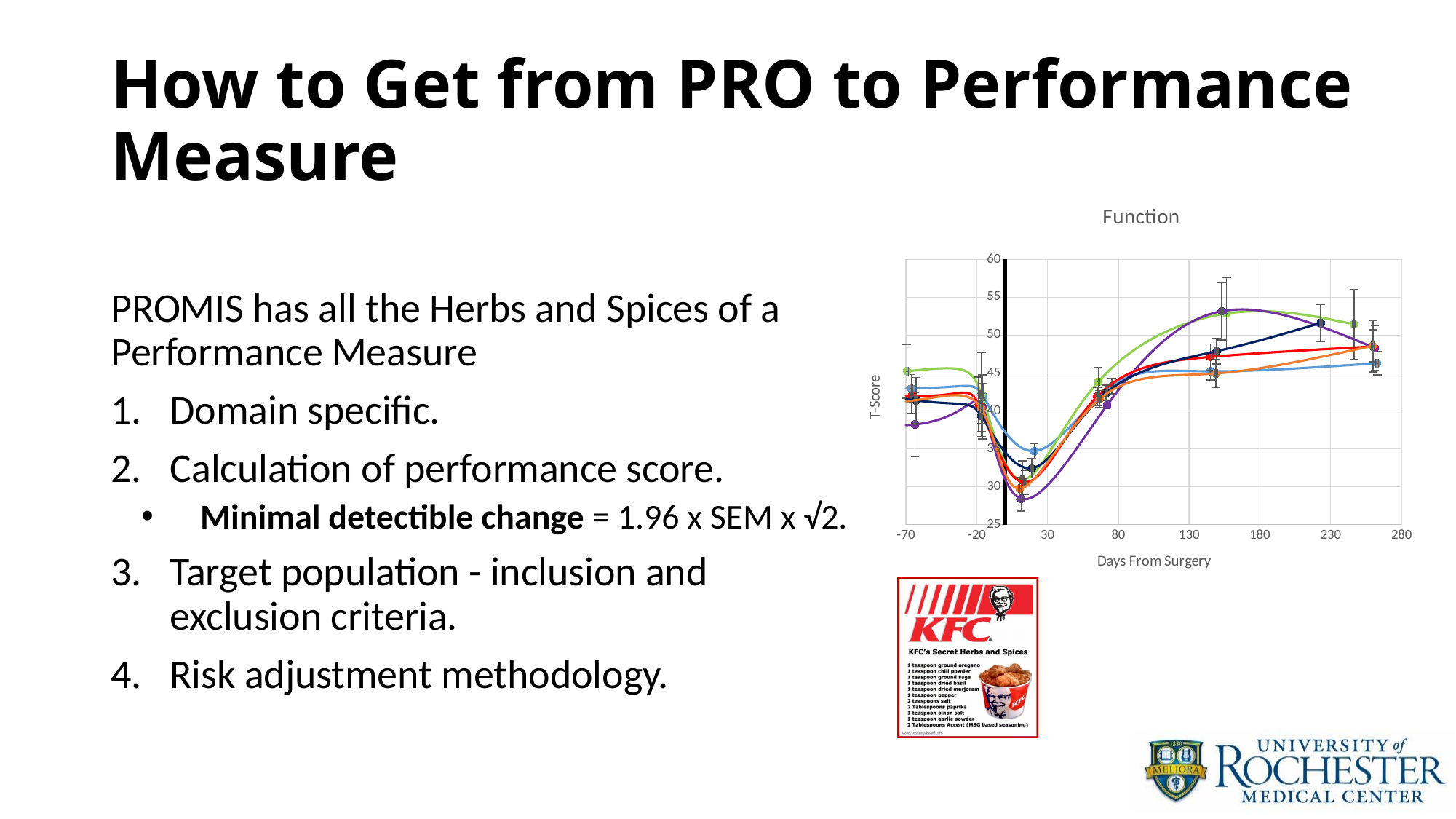
What kind of chart is shown on the slide? line chart What is the first tick value shown on the x-axis (Days From Surgery)? -70 What is the lowest value shown on the y-axis of the chart? 25 Do the T-Score values generally rise or fall between about day 10 and day 130 after surgery? rise Is the value of the purple line at -70 days greater or less than 40? less What is the last tick value shown on the x-axis (Days From Surgery)? 280 Is the peak of the purple line (around day 150) greater or less than 50 on the T-Score axis? greater Is the lowest point of the purple line greater or less than 30 on the T-Score axis? less What is the label of the y-axis of the chart? T-Score What is the title of the chart? Function What is the highest value shown on the y-axis of the chart? 60 Do the T-Score values rise or fall between -20 days and about 10 days from surgery? fall